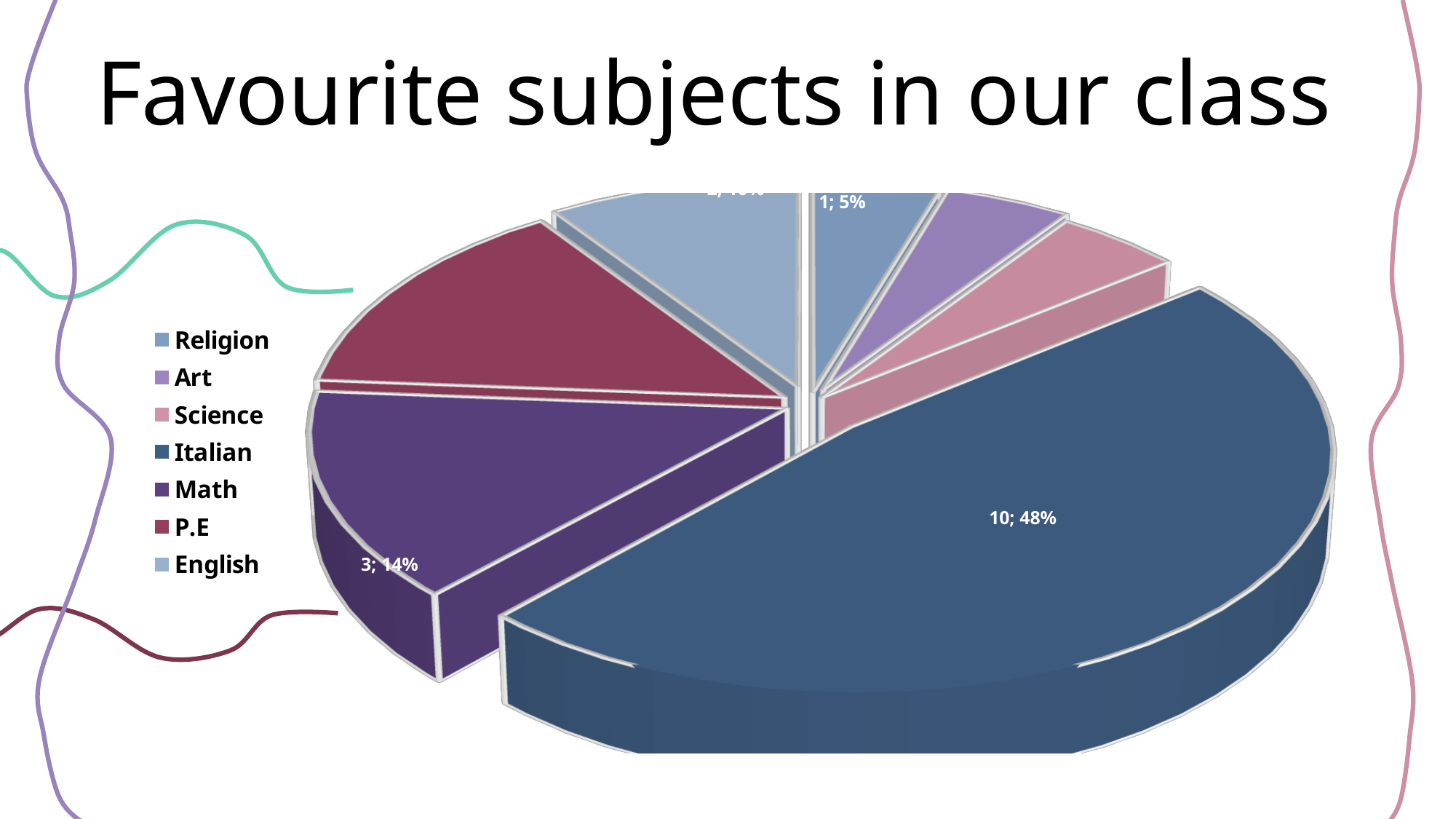
What percentage of the class chose Math? 14% What percentage of the class chose Religion? 5% What is the title of the chart? Favourite subjects in our class Which has more students, Italian or Math? Italian How many subjects does the legend list? 7 What percentage of the class chose Italian as their favourite subject? 48% Which subject is shown in the dark blue colour in the legend? Italian Which subject has the largest slice of the pie? Italian How many more students chose Italian than Math? 7 How many students chose Italian as their favourite subject? 10 How many students chose Math? 3 What kind of chart is shown on the slide? pie chart